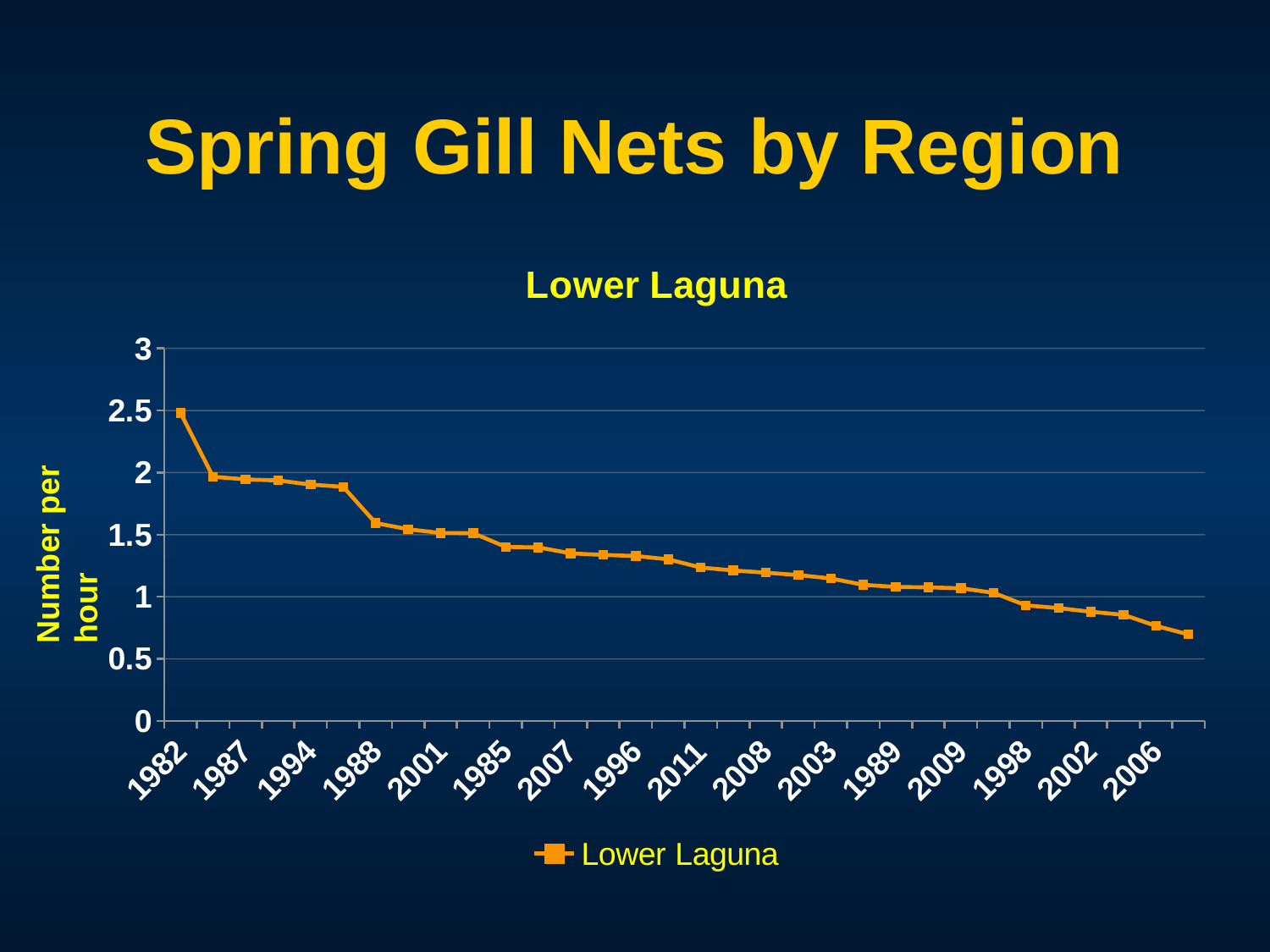
How many series does the legend list? 1 What is the name of the series shown in the legend? Lower Laguna Is the value for 1988 greater or less than 1.5? greater Is the value for 1987 greater or less than 2? less What is the title of the y axis? Number per hour Is the value for 2006 greater or less than 1? less Which year has the highest value in the Lower Laguna chart? 1982 Do the values rise or fall moving left to right along the x axis? fall What kind of chart is shown on the slide? line chart Which has the larger value, 1982 or 2006? 1982